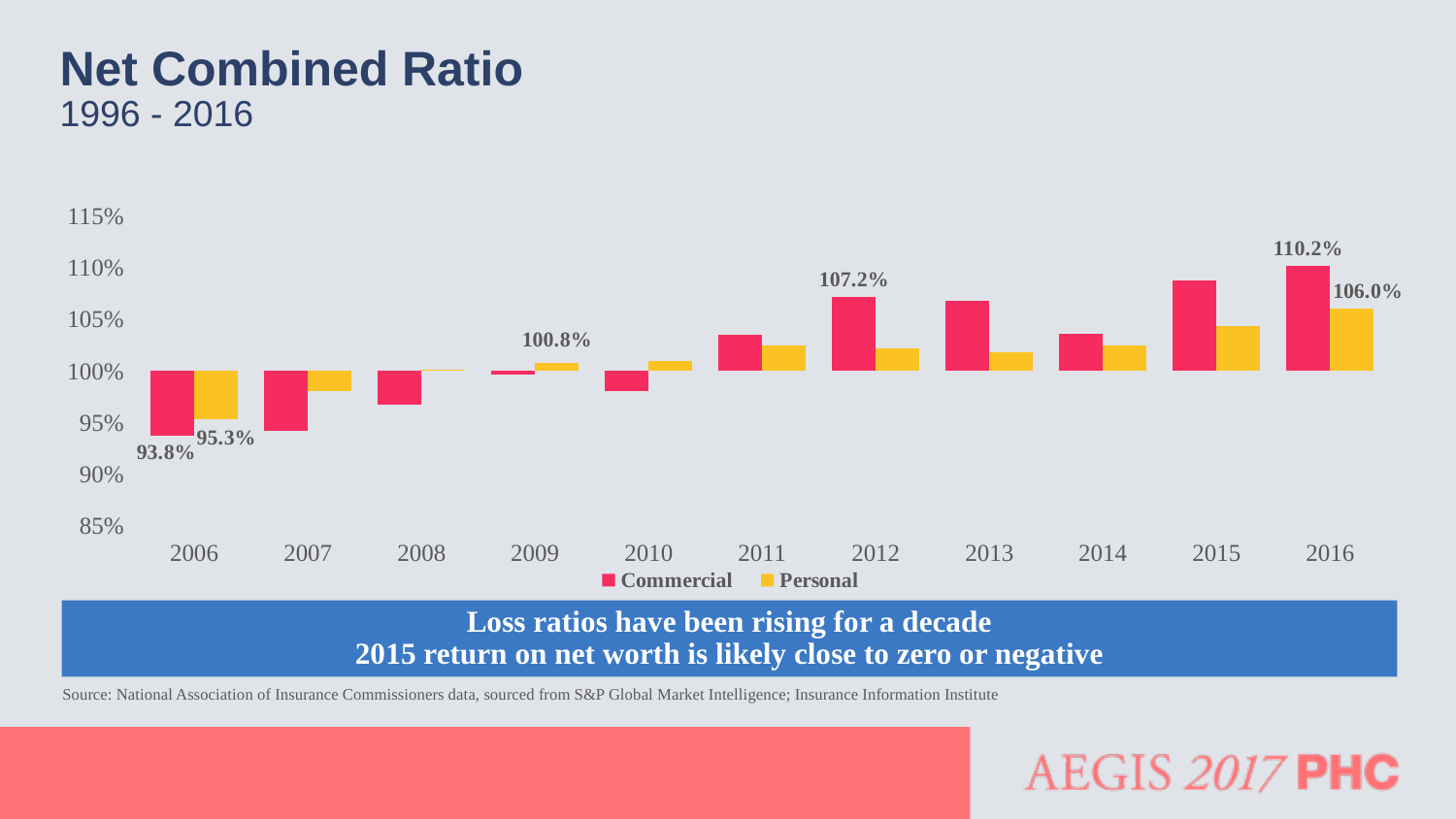
Is the Commercial net combined ratio for 2013 greater or less than 105%? greater What is the Personal net combined ratio for 2009? 100.8% How many years are shown on the x axis of the chart? 11 In 2006, which series has the higher net combined ratio, Commercial or Personal? Personal What is the difference between the Commercial and Personal net combined ratios in 2016? 4.2 percentage points In which year is the Personal net combined ratio lowest? 2006 In which year is the Commercial net combined ratio highest? 2016 What type of chart is shown on the slide? Bar chart What is the Personal net combined ratio for 2016? 106.0% What is the Commercial net combined ratio for 2012? 107.2% What is the Commercial net combined ratio for 2006? 93.8% How many series does the chart's legend list? 2